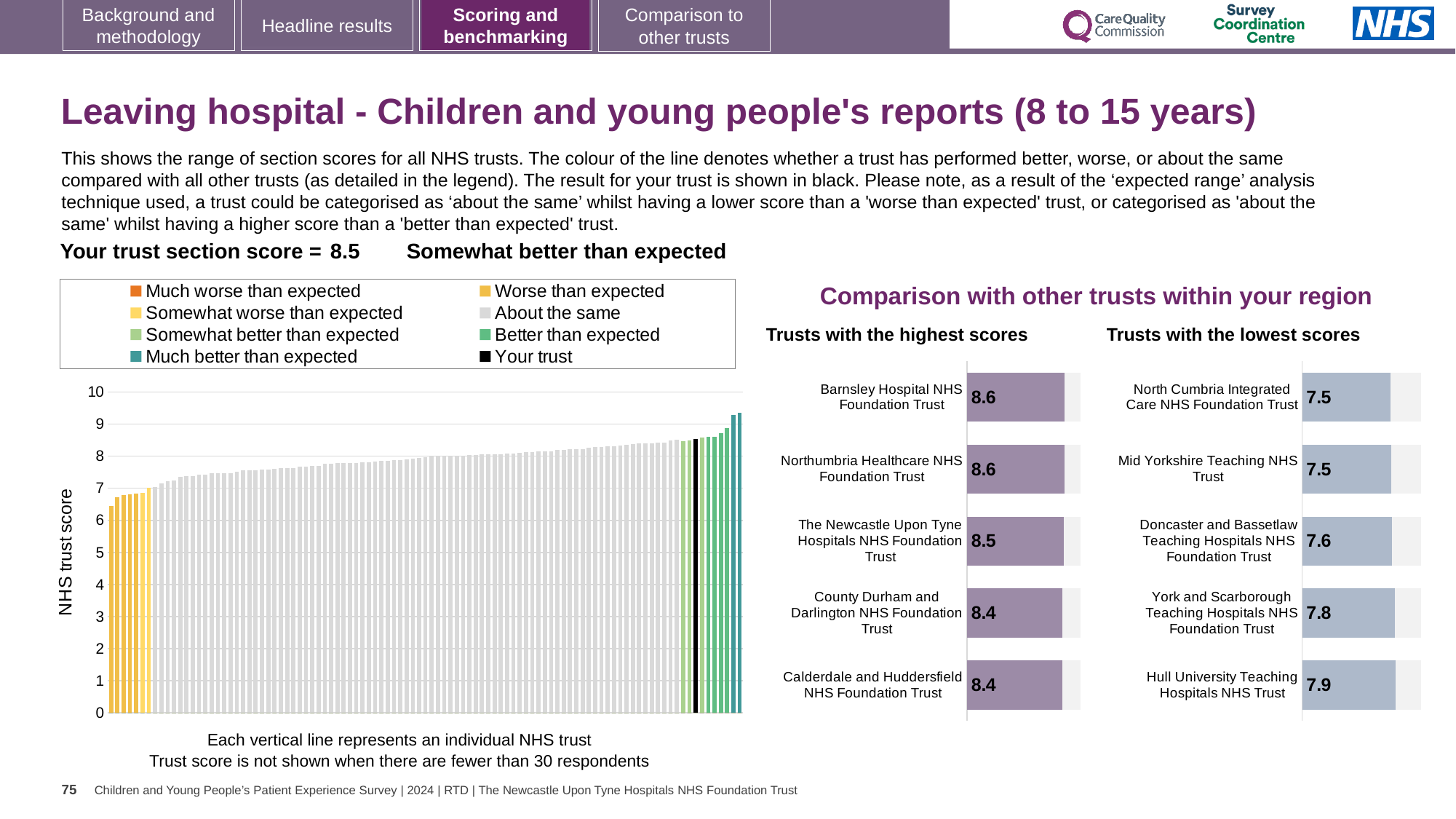
In the 'Trusts with the lowest scores' chart, what is the difference between the scores of Hull University Teaching Hospitals NHS Trust and North Cumbria Integrated Care NHS Foundation Trust? 0.4 In the 'Trusts with the lowest scores' chart, what is the score for Hull University Teaching Hospitals NHS Trust? 7.9 In the 'Trusts with the lowest scores' chart, which has the larger score: York and Scarborough Teaching Hospitals NHS Foundation Trust or Mid Yorkshire Teaching NHS Trust? York and Scarborough Teaching Hospitals NHS Foundation Trust In the large 'NHS trust score' chart on the left, is the value of the tallest bar greater or less than 9? greater In the large 'NHS trust score' chart on the left, do the bar values rise or fall from left to right? rise In the 'Trusts with the highest scores' chart, what is the difference between the scores of Barnsley Hospital NHS Foundation Trust and Calderdale and Huddersfield NHS Foundation Trust? 0.2 In the 'Trusts with the lowest scores' chart, which trust has the highest score? Hull University Teaching Hospitals NHS Trust How many entries does the legend above the large 'NHS trust score' chart list? 8 How many trusts are listed in the 'Trusts with the highest scores' chart? 5 In the 'Trusts with the lowest scores' chart, what is the score for Doncaster and Bassetlaw Teaching Hospitals NHS Foundation Trust? 7.6 In the 'Trusts with the highest scores' chart, what is the score for Barnsley Hospital NHS Foundation Trust? 8.6 In the 'Trusts with the highest scores' chart, what is the score for County Durham and Darlington NHS Foundation Trust? 8.4